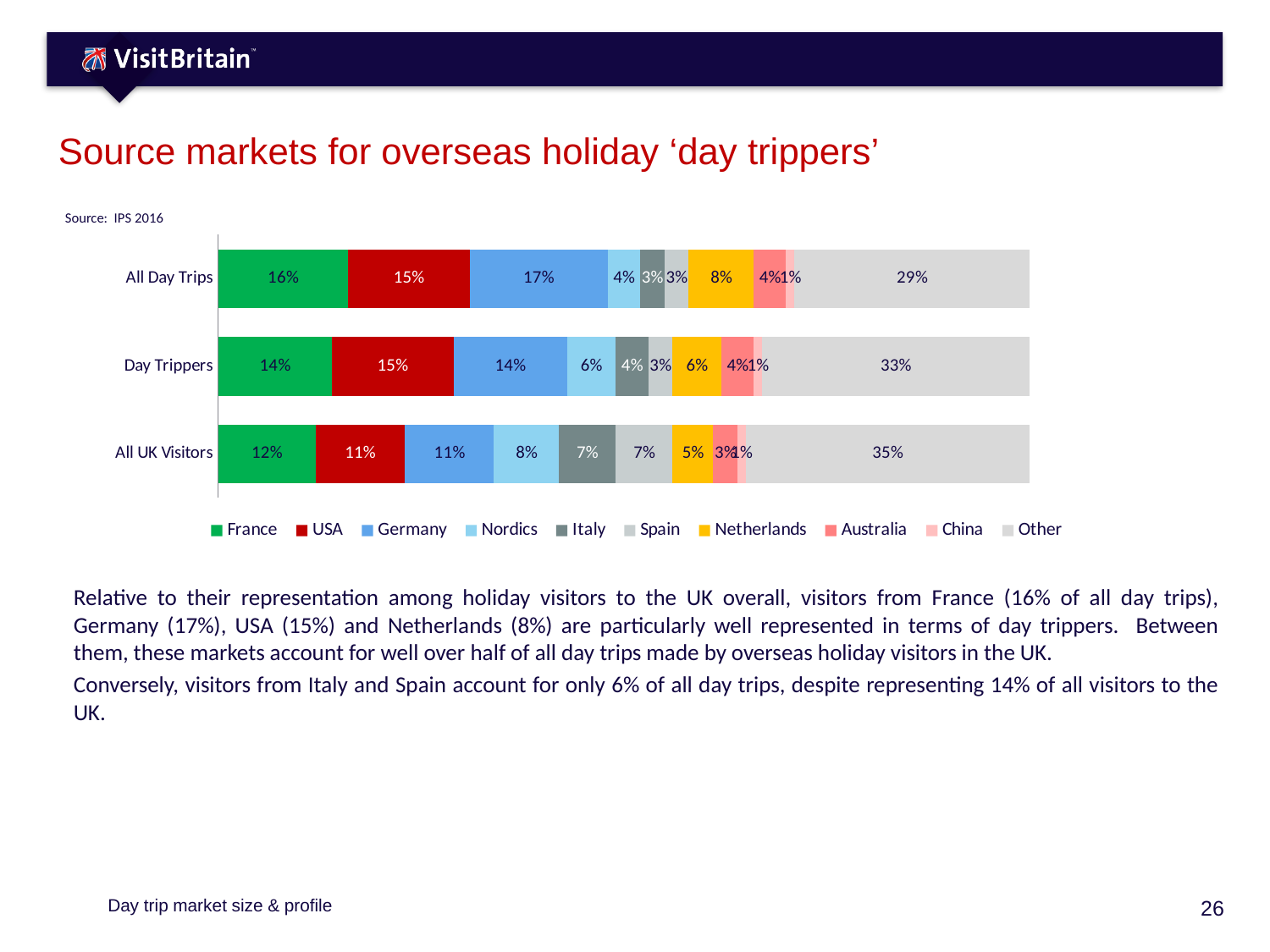
What is the difference between the Germany value for All Day Trips and for All UK Visitors? 6% Which category has the lowest value for France? All UK Visitors What is the value for Nordics in the All UK Visitors bar? 8% What type of chart is shown on the slide? Stacked bar chart Is the Italy value larger for All Day Trips or for All UK Visitors? All UK Visitors How many bars (categories) are shown in the chart? 3 What is the value for Other in the Day Trippers bar? 33% What is the source cited for the chart? IPS 2016 How many series does the legend list? 10 What is the value for Netherlands in the All Day Trips bar? 8% Which category has the highest value for Other? All UK Visitors What is the value for Germany in the All Day Trips bar? 17%